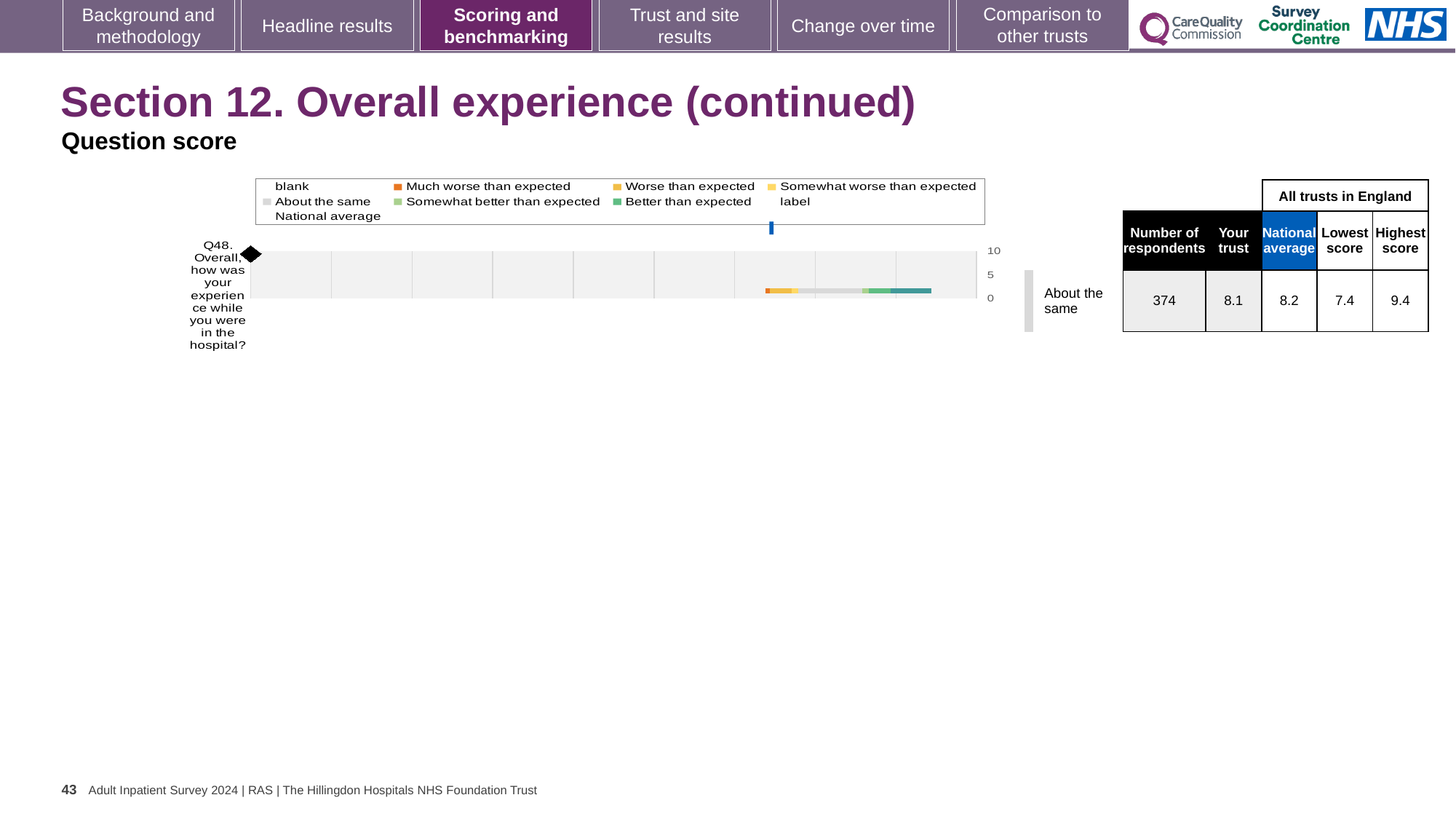
What is the highest score among all trusts in England for Q48? 9.4 What is the 'Your trust' score for Q48? 8.1 For Q48, what is the difference between the national average and the 'Your trust' score? 0.1 For Q48, which is larger: the 'Your trust' score or the national average? National average What kind of chart is used to show the Q48 question score? bar chart For Q48, what is the difference between the highest score and the lowest score among all trusts in England? 2.0 What is the lowest score among all trusts in England for Q48? 7.4 What benchmark category label is shown next to the Q48 bar? About the same What is the national average score for Q48? 8.2 How many survey questions are plotted in the chart? 1 Which survey question is plotted in the chart? Q48. Overall, how was your experience while you were in the hospital? What is the number of respondents for Q48? 374